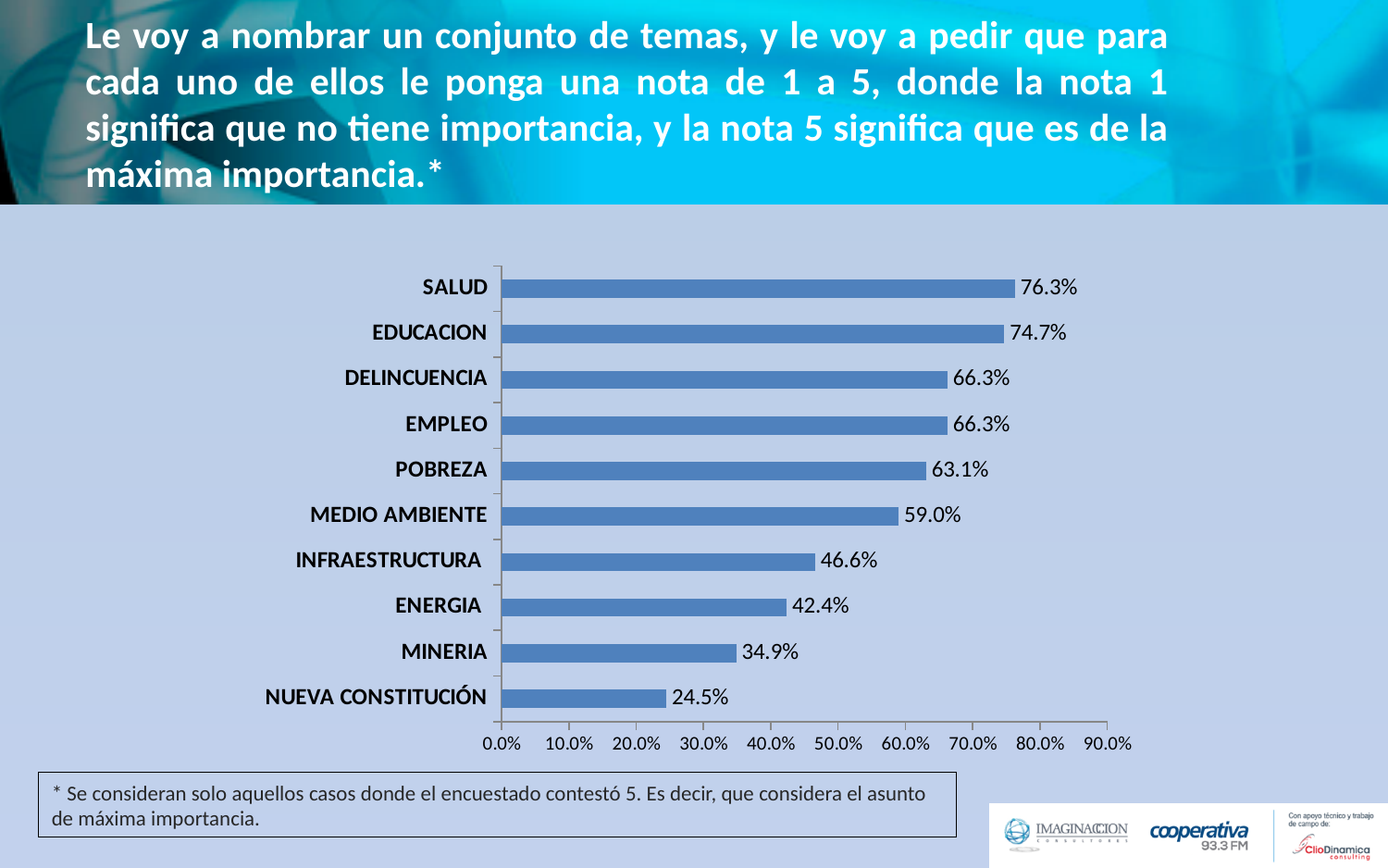
Which two categories share the same value of 66.3%? DELINCUENCIA and EMPLEO Is the value for ENERGIA greater or less than 50.0%? less What kind of chart is shown on the slide? bar chart What is the value for MEDIO AMBIENTE? 59.0% Which category has the lowest value? NUEVA CONSTITUCIÓN What is the value for SALUD? 76.3% Which is larger, the value for POBREZA or the value for MEDIO AMBIENTE? POBREZA What is the value for MINERIA? 34.9% Which category has the highest value? SALUD How many categories are shown in the chart? 10 What is the difference between the values for INFRAESTRUCTURA and ENERGIA? 4.2% What is the difference between the values for SALUD and EDUCACION? 1.6%